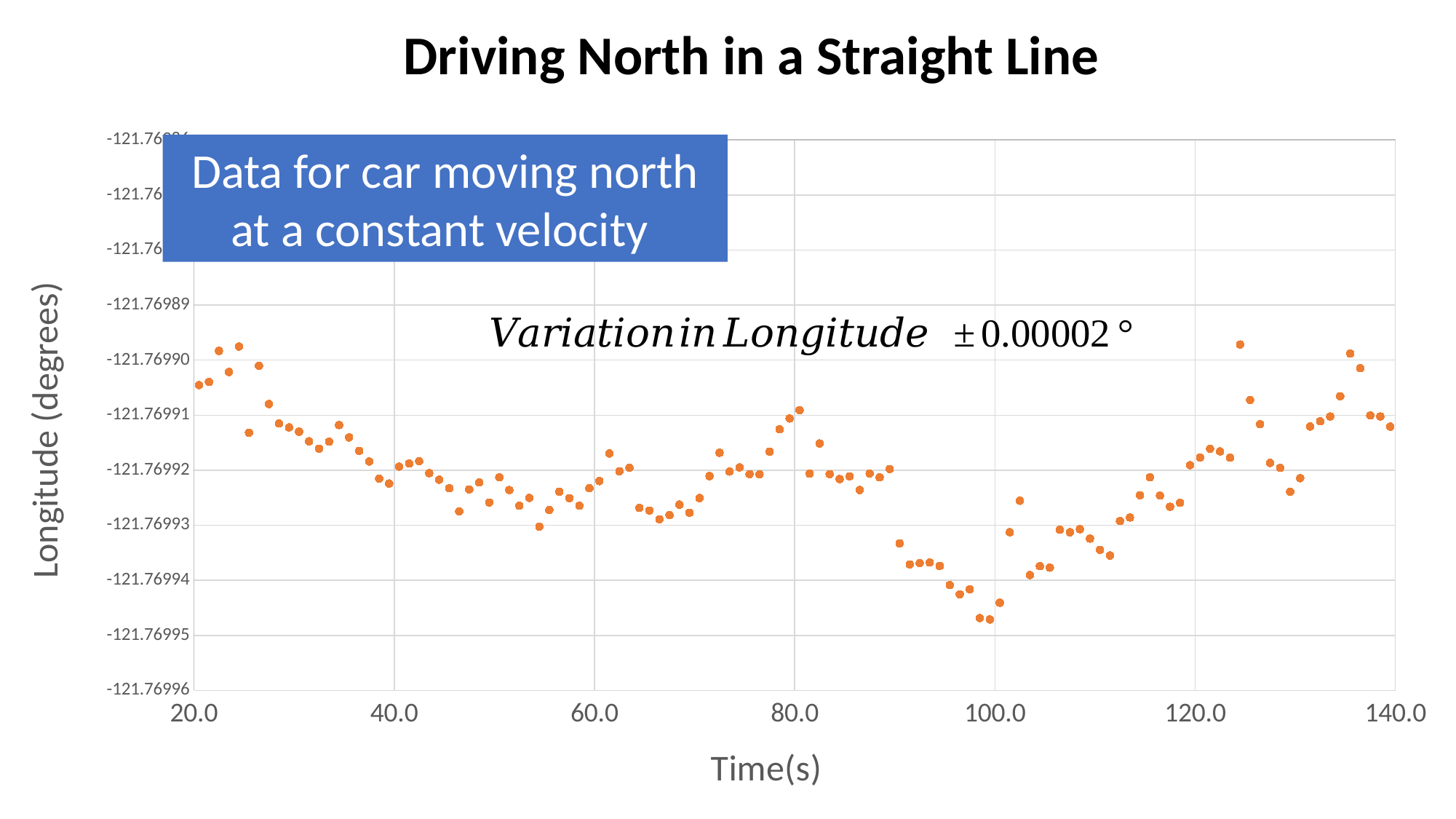
Is the longitude value at time 80.0 s greater or less than -121.76992? greater Which is larger: the longitude value at time 80.0 s or at time 100.0 s? 80.0 s Between time 100 s and 120 s, do the longitude values rise or fall? rise Between time 90 s and 100 s, do the longitude values rise or fall? fall What kind of chart is shown on the slide? scatter chart Is the lowest point on the chart located before or after time 80.0 s? after Is the longitude value at time 60.0 s greater or less than -121.76992? less Is the lowest longitude value on the chart (near 100 s) greater or less than -121.76994? less What variation in longitude is stated in the annotation on the chart? ±0.00002° What is the title of the chart? Driving North in a Straight Line